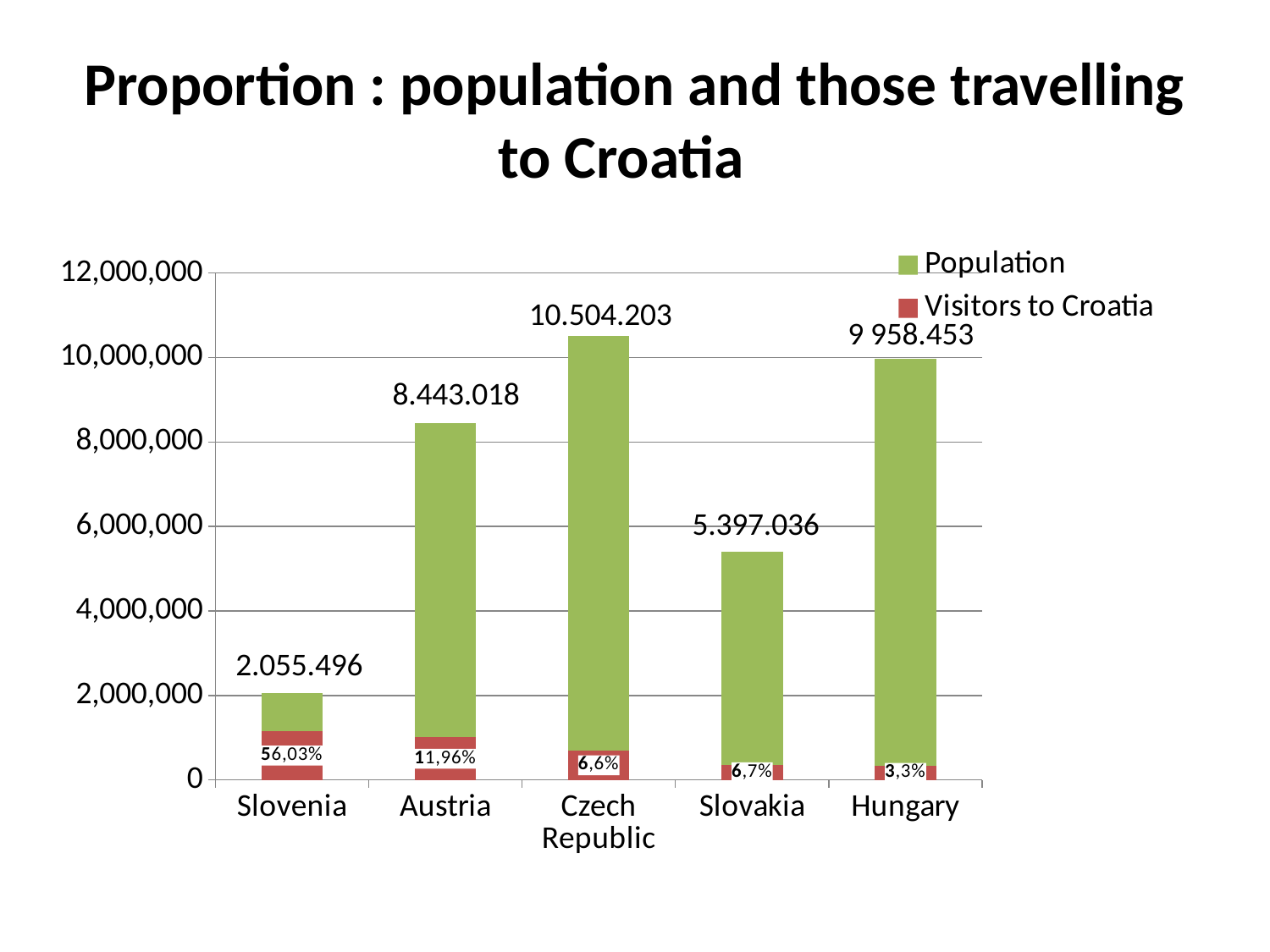
Which has the larger population bar, Austria or Slovakia? Austria What is the population value labelled for Slovenia? 2.055.496 What kind of chart is shown on the slide? bar chart Which country has the lowest population bar? Slovenia What percentage is labelled on the Visitors to Croatia segment for Slovenia? 56,03% Is the population bar for Slovakia greater or less than 6,000,000? less What is the population value labelled for the Czech Republic? 10.504.203 Which country has the highest population bar? Czech Republic What is the population value labelled for Austria? 8.443.018 What percentage is labelled on the Visitors to Croatia segment for Hungary? 3,3% How many countries are shown on the x axis? 5 How many series does the legend list? 2